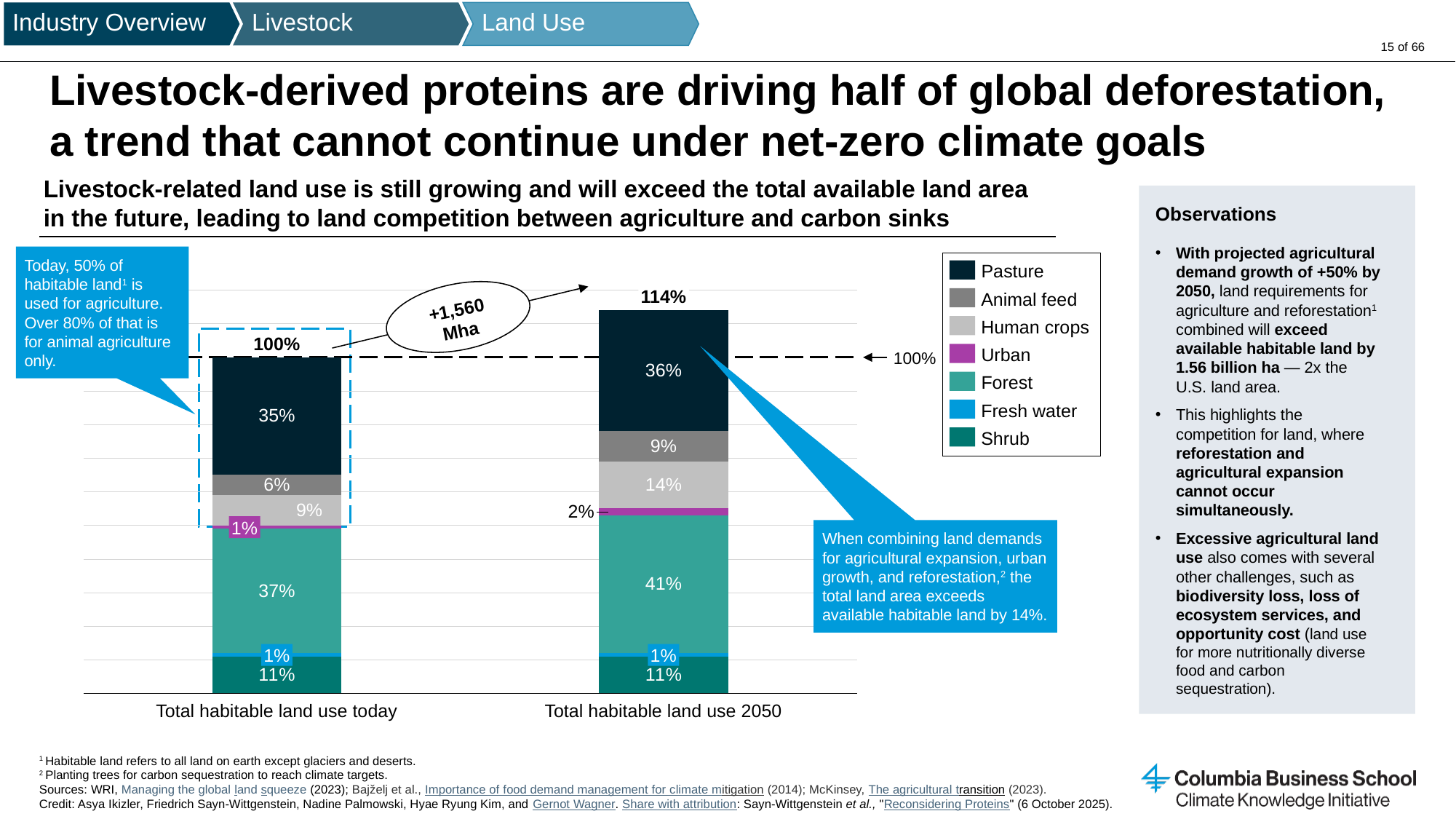
Which segment is larger in the 2050 bar: Animal feed or Human crops? Human crops What is the Pasture share for Total habitable land use today? 35% What is the total of the stacked bar for Total habitable land use 2050? 114% Which segment is the largest in the Total habitable land use today bar? Forest What is the Forest share for Total habitable land use 2050? 41% By how many percentage points does the Human crops share in 2050 exceed the Human crops share today? 5% How many series does the chart legend list? 7 What is the Human crops share for Total habitable land use 2050? 14% What kind of chart is shown on the slide? Stacked bar chart What value is shown in the oval between the two bars? +1,560 Mha How many bars (categories) are plotted in the chart? 2 What is the total of the stacked bar for Total habitable land use today? 100%